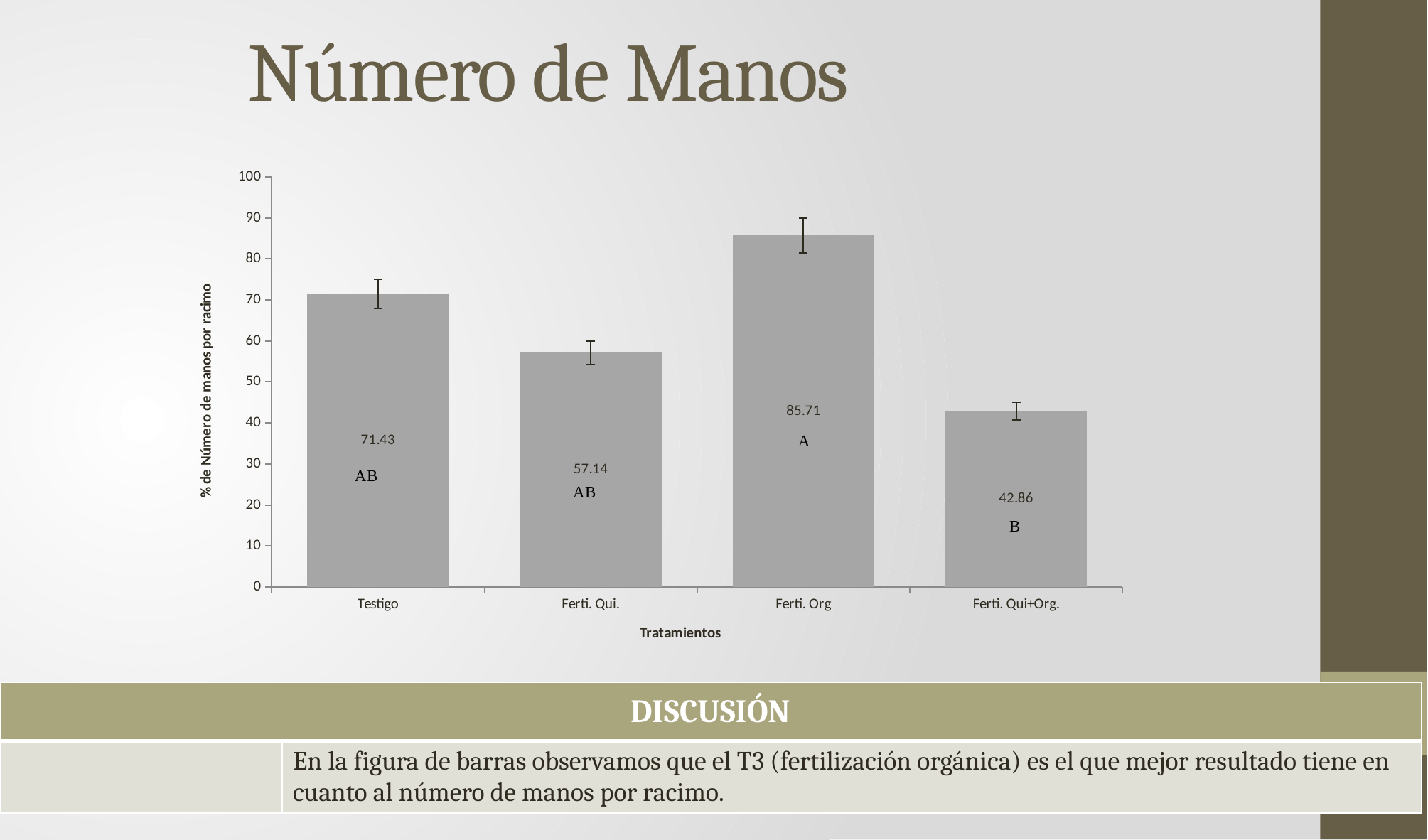
What is the difference between the values for Ferti. Org and Ferti. Qui+Org.? 42.85 Which treatment has the highest value? Ferti. Org What is the value for Ferti. Qui+Org.? 42.86 Which is larger, the value for Testigo or the value for Ferti. Qui.? Testigo How many treatments are shown on the x axis? 4 What is the label of the x axis? Tratamientos What is the value for Testigo? 71.43 Which treatment has the lowest value? Ferti. Qui+Org. What is the difference between the values for Testigo and Ferti. Qui.? 14.29 What is the value for Ferti. Qui.? 57.14 What kind of chart is shown on the slide? Bar chart What is the value for Ferti. Org? 85.71